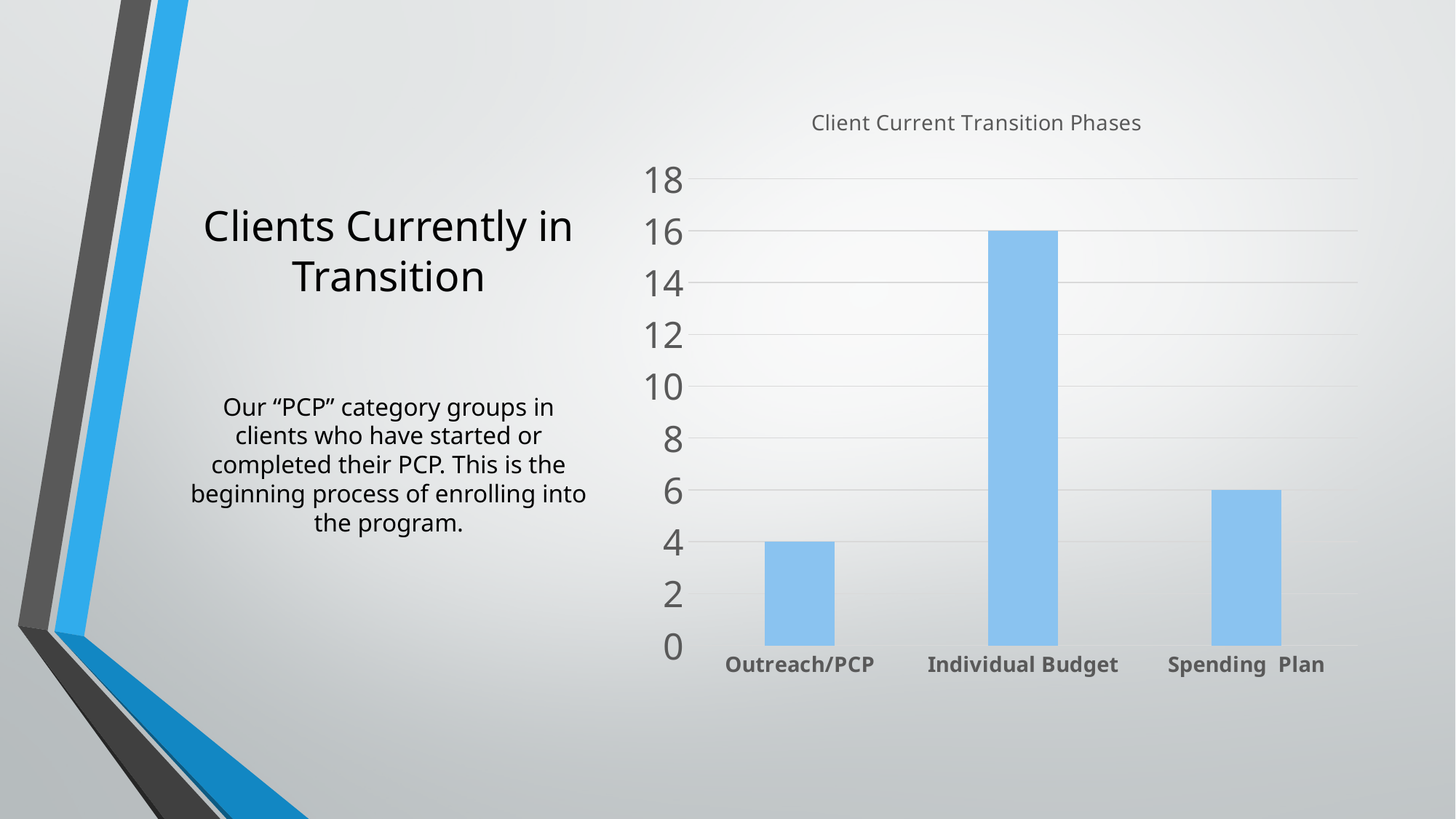
What is the difference between the values for Individual Budget and Spending Plan? 10 What is the difference between the values for Spending Plan and Outreach/PCP? 2 What is the title of the chart? Client Current Transition Phases Which is larger, the value for Outreach/PCP or the value for Spending Plan? Spending Plan Is the value for Individual Budget greater or less than 10? greater How many categories are shown on the x axis? 3 What is the value for Individual Budget? 16 What is the value for Outreach/PCP? 4 Which category has the lowest value? Outreach/PCP What is the value for Spending Plan? 6 What kind of chart is shown on the slide? bar chart Which category has the highest value? Individual Budget